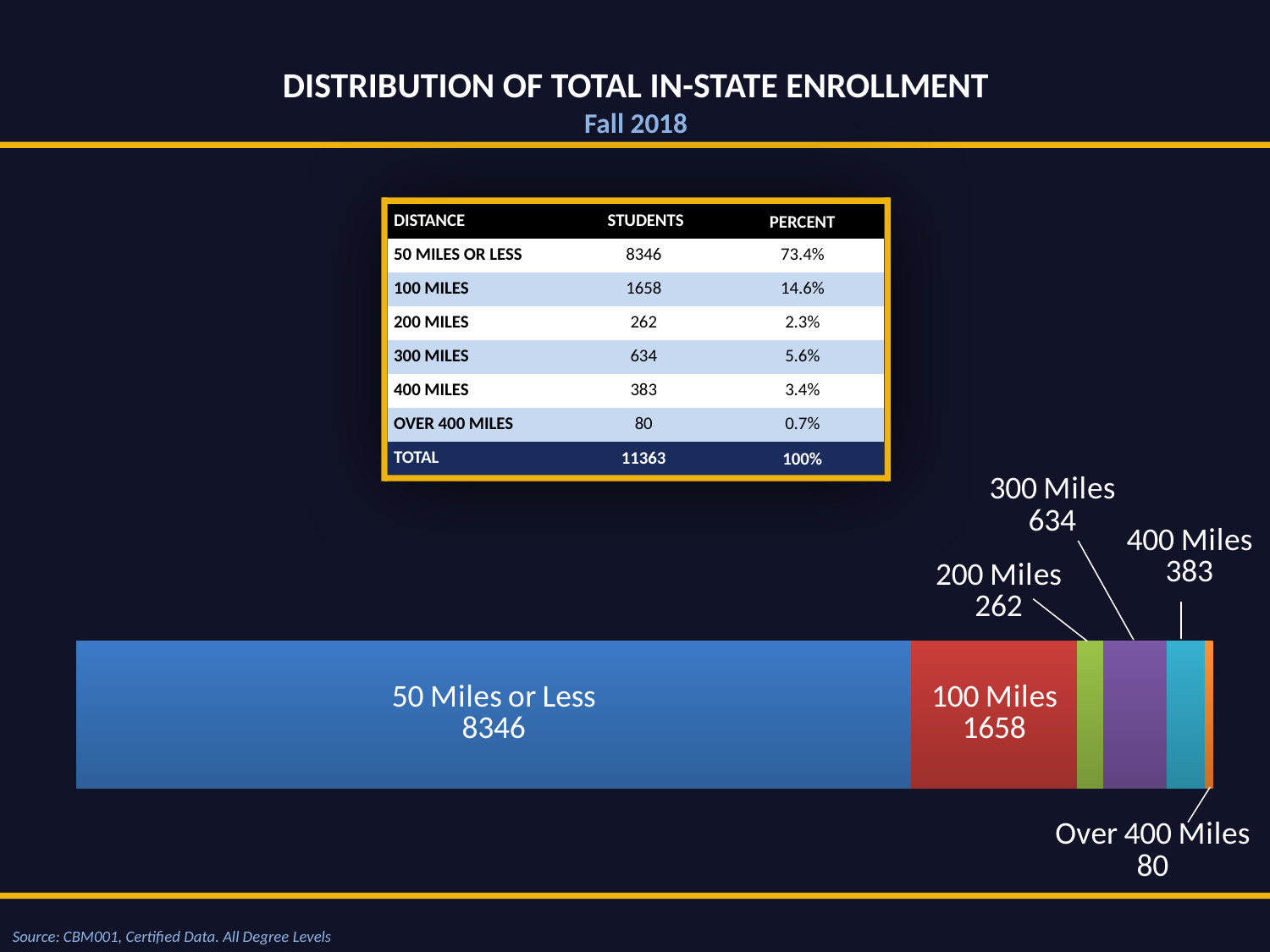
What kind of chart is shown on the slide? bar chart Which segment of the bar is the smallest? Over 400 Miles What is the total of all segments in the stacked bar? 11363 Which is larger, the 300 Miles segment or the 400 Miles segment? 300 Miles What is the difference between the 50 Miles or Less value and the 100 Miles value? 6688 Which segment of the bar is the largest? 50 Miles or Less What is the value for the Over 400 Miles segment? 80 What is the value for the 100 Miles segment? 1658 What is the value for the 300 Miles segment? 634 What colour is the 100 Miles segment of the bar? red What is the value for the 50 Miles or Less segment? 8346 How many segments does the stacked bar contain? 6